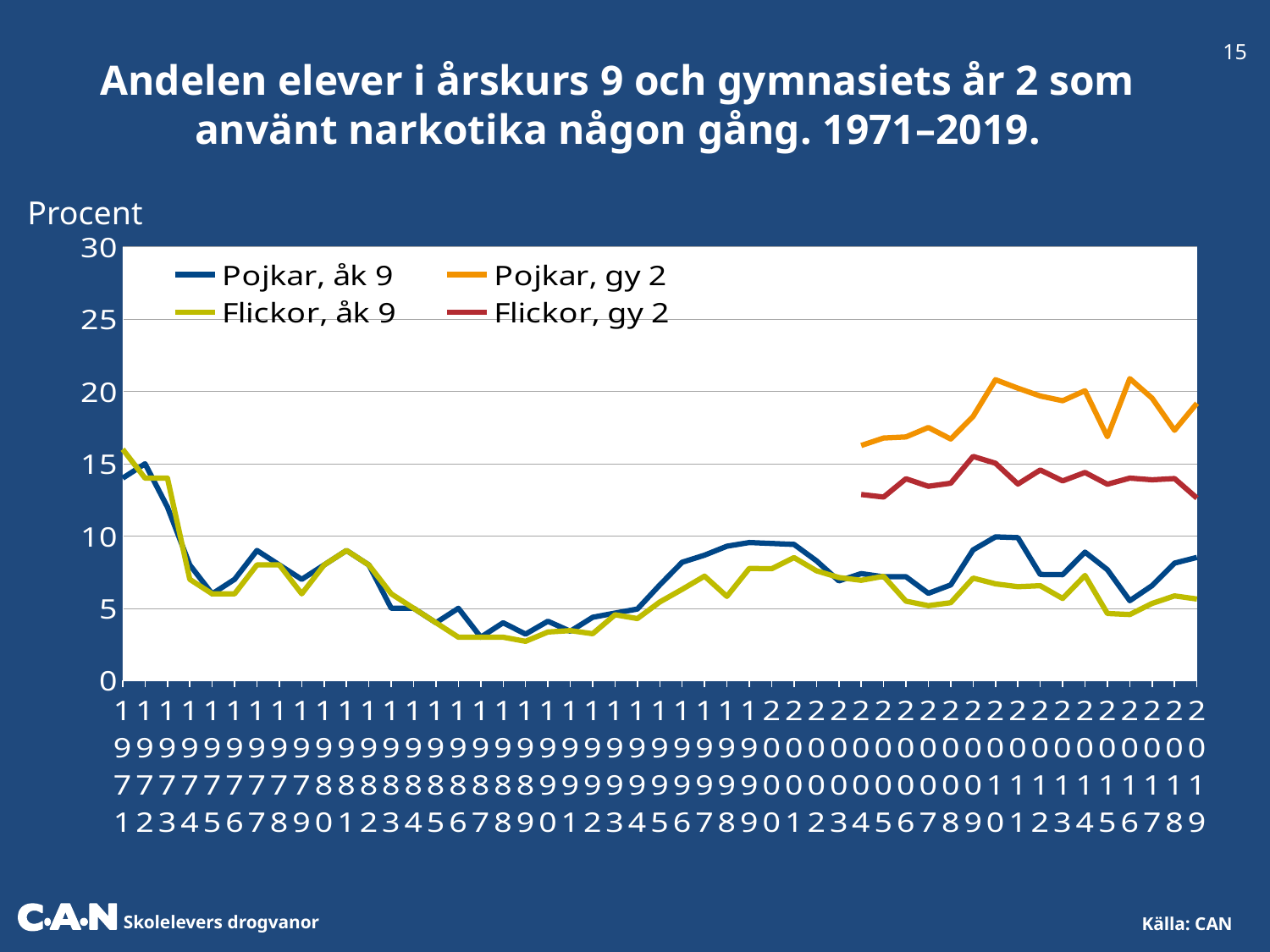
How many series does the legend list? 4 Does the Pojkar, åk 9 line rise or fall from 1971 to 1989? Fall How many years are shown on the x axis? 49 Which series has the highest value in 2019? Pojkar, gy 2 In 2019, which is larger: Pojkar, åk 9 or Flickor, åk 9? Pojkar, åk 9 Is the value for Flickor, åk 9 in 2019 greater or less than 10? less Is the value for Pojkar, åk 9 in 1971 greater or less than 10? greater What is the label on the vertical axis? Procent What kind of chart is shown on the slide? Line chart Which series are listed in the legend? Pojkar, åk 9; Pojkar, gy 2; Flickor, åk 9; Flickor, gy 2 Is the value for Pojkar, gy 2 in 2019 greater or less than 15? greater